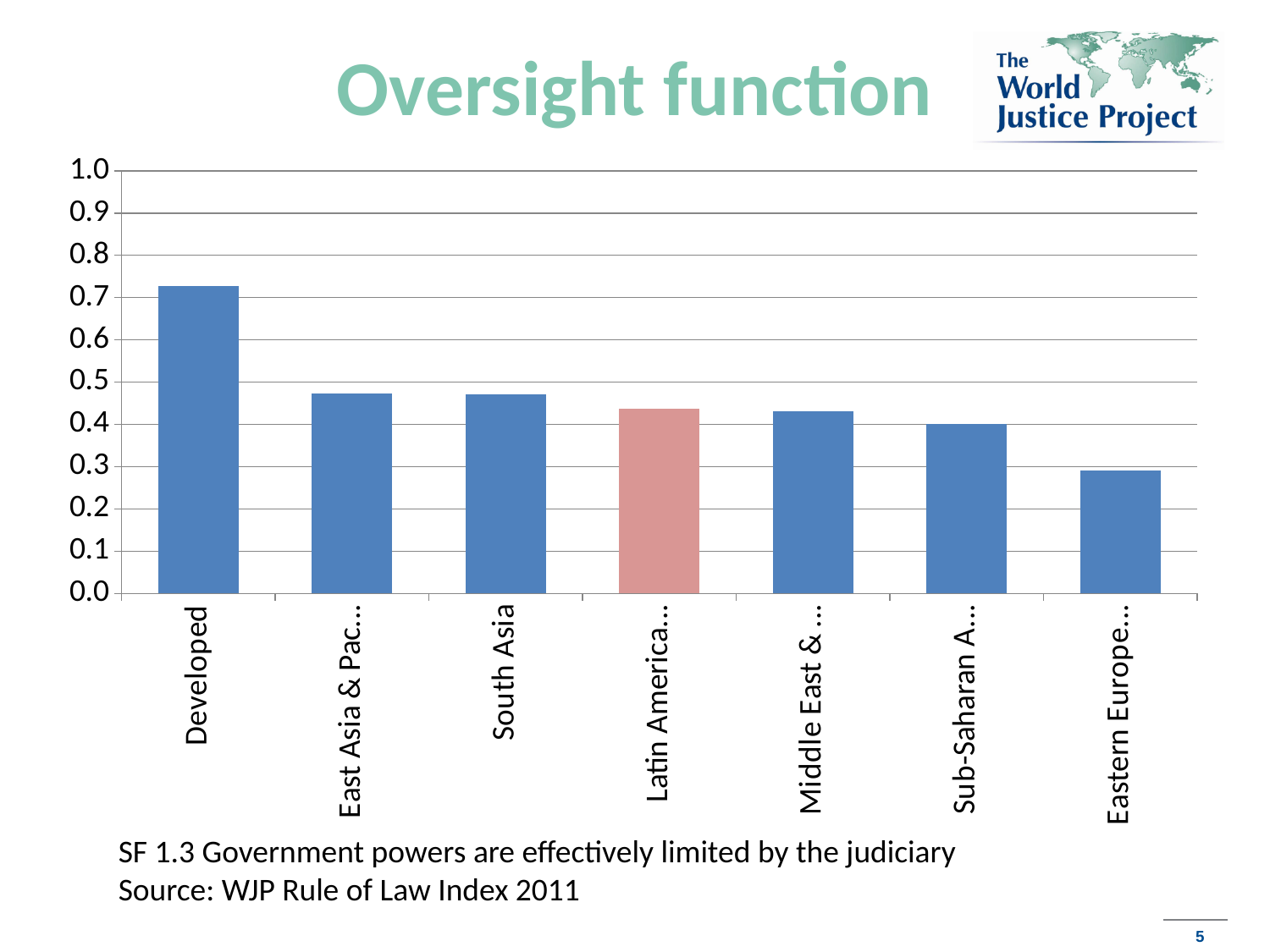
Which is larger, the value for Developed or the value for Eastern Europe…? Developed Is the value for Sub-Saharan A… greater or less than 0.5? less Which category has the lowest value in the chart? Eastern Europe… What kind of chart is shown on the slide? bar chart Is the value for Eastern Europe… greater or less than 0.4? less Which is larger, the value for East Asia & Pac… or the value for Sub-Saharan A…? East Asia & Pac… How many categories (bars) are plotted in the chart? 7 Is the value for Latin America… greater or less than 0.4? greater Which category has the highest value in the chart? Developed Which category's bar is coloured differently (pink) from the other blue bars? Latin America… Do the bar values generally rise or fall from left to right along the x axis? fall